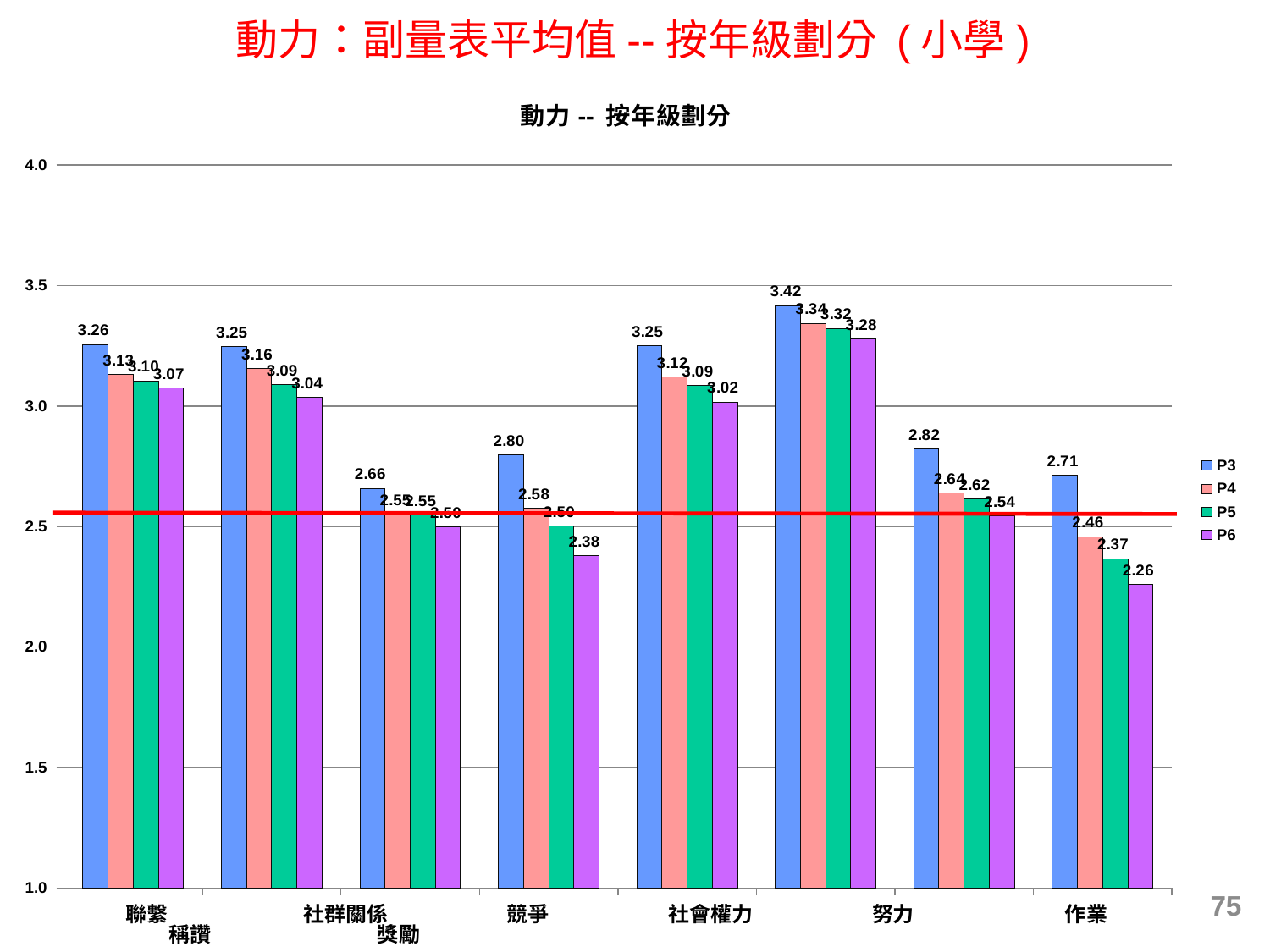
How many categories are shown on the x axis? 8 What is the title of the chart? 動力 -- 按年級劃分 What type of chart is shown on the slide? bar chart Which is larger, the P5 value for 聯繫 or the P5 value for 稱讚? P5 value for 聯繫 Within the 社會權力 category, do the values rise or fall from P3 to P6? fall How many series does the legend list? 4